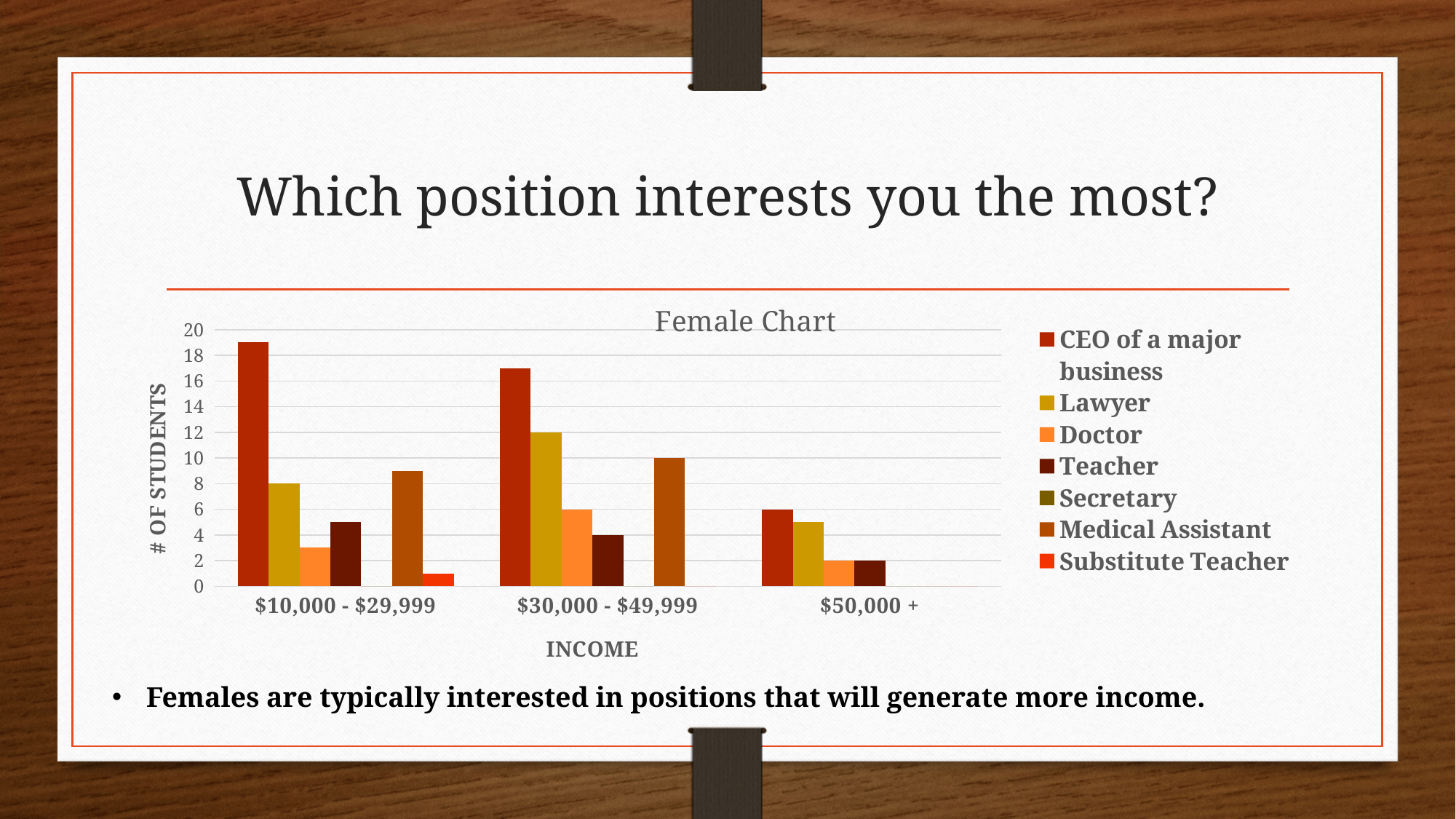
Is the value for CEO of a major business in the $10,000 - $29,999 category greater or less than 18? greater How many income categories are shown on the x axis of the Female Chart? 3 Does the number of students choosing CEO of a major business rise or fall across the income categories from left to right? fall How many students chose Lawyer in the $30,000 - $49,999 income category? 12 Is the value for Medical Assistant in the $10,000 - $29,999 category greater or less than 8? greater Which position has the highest number of students in the $10,000 - $29,999 income category? CEO of a major business What type of chart is the Female Chart? bar chart How many series does the legend of the Female Chart list? 7 How many students chose Medical Assistant in the $30,000 - $49,999 income category? 10 Which position has the highest number of students in the $30,000 - $49,999 income category? CEO of a major business What is the label of the y axis on the Female Chart? # OF STUDENTS Which is larger in the $30,000 - $49,999 category: the value for Lawyer or the value for Doctor? Lawyer